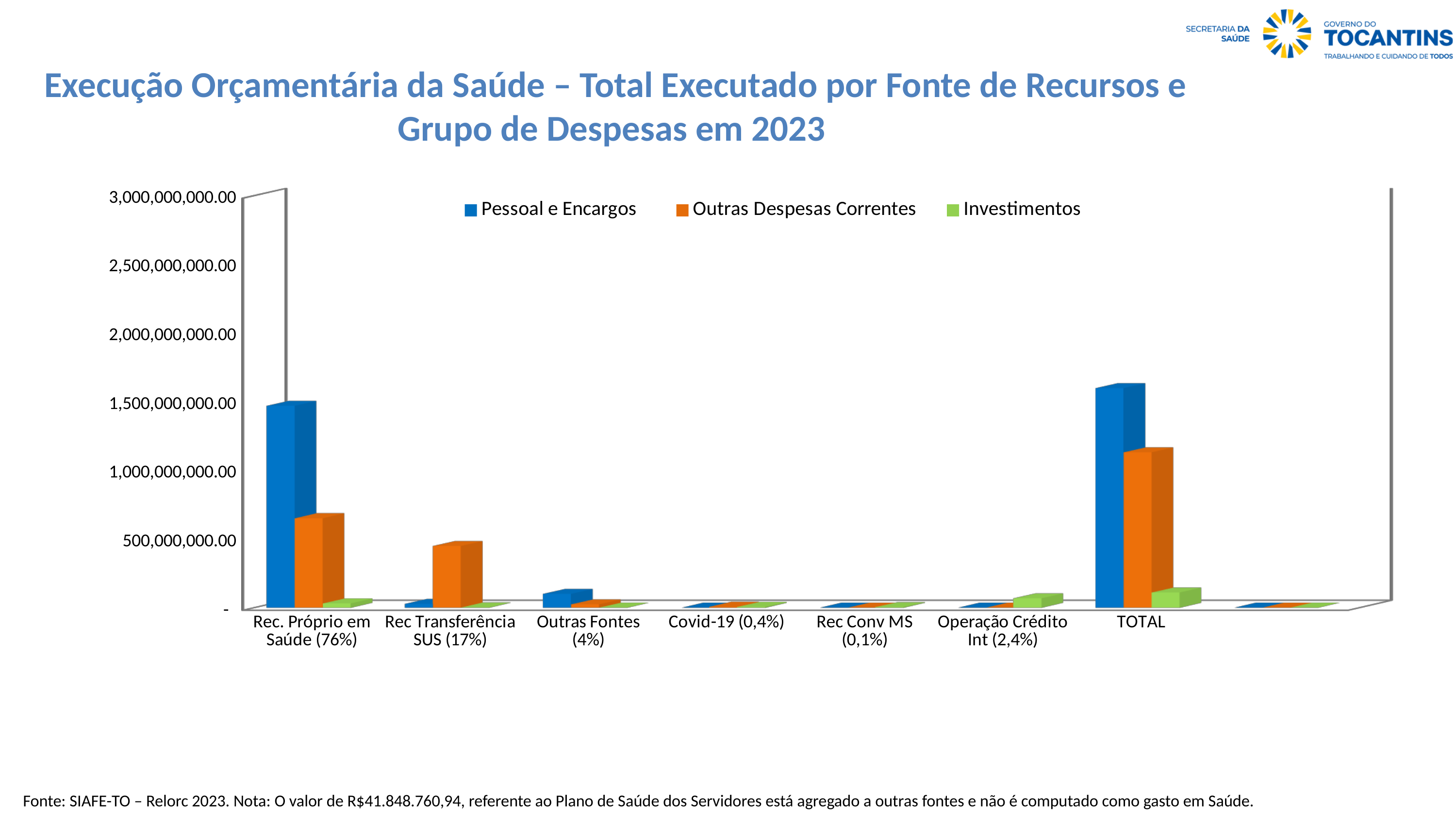
How many series does the legend list? 3 Which series is shown in green in the legend? Investimentos Is the Outras Despesas Correntes value for TOTAL greater or less than 1,000,000,000.00? greater Excluding TOTAL, which funding source has the tallest Investimentos bar? Operação Crédito Int (2,4%) Which category has the tallest Pessoal e Encargos bar? TOTAL What kind of chart is shown on the slide? bar chart Is the Pessoal e Encargos value for Rec. Próprio em Saúde (76%) greater or less than 1,000,000,000.00? greater Excluding TOTAL, which funding source has the tallest Pessoal e Encargos bar? Rec. Próprio em Saúde (76%) How many categories are shown on the x axis? 7 Is the Pessoal e Encargos value for TOTAL greater or less than 2,000,000,000.00? less For Rec. Próprio em Saúde (76%), which is larger: Pessoal e Encargos or Outras Despesas Correntes? Pessoal e Encargos For Rec Transferência SUS (17%), which is larger: Pessoal e Encargos or Outras Despesas Correntes? Outras Despesas Correntes